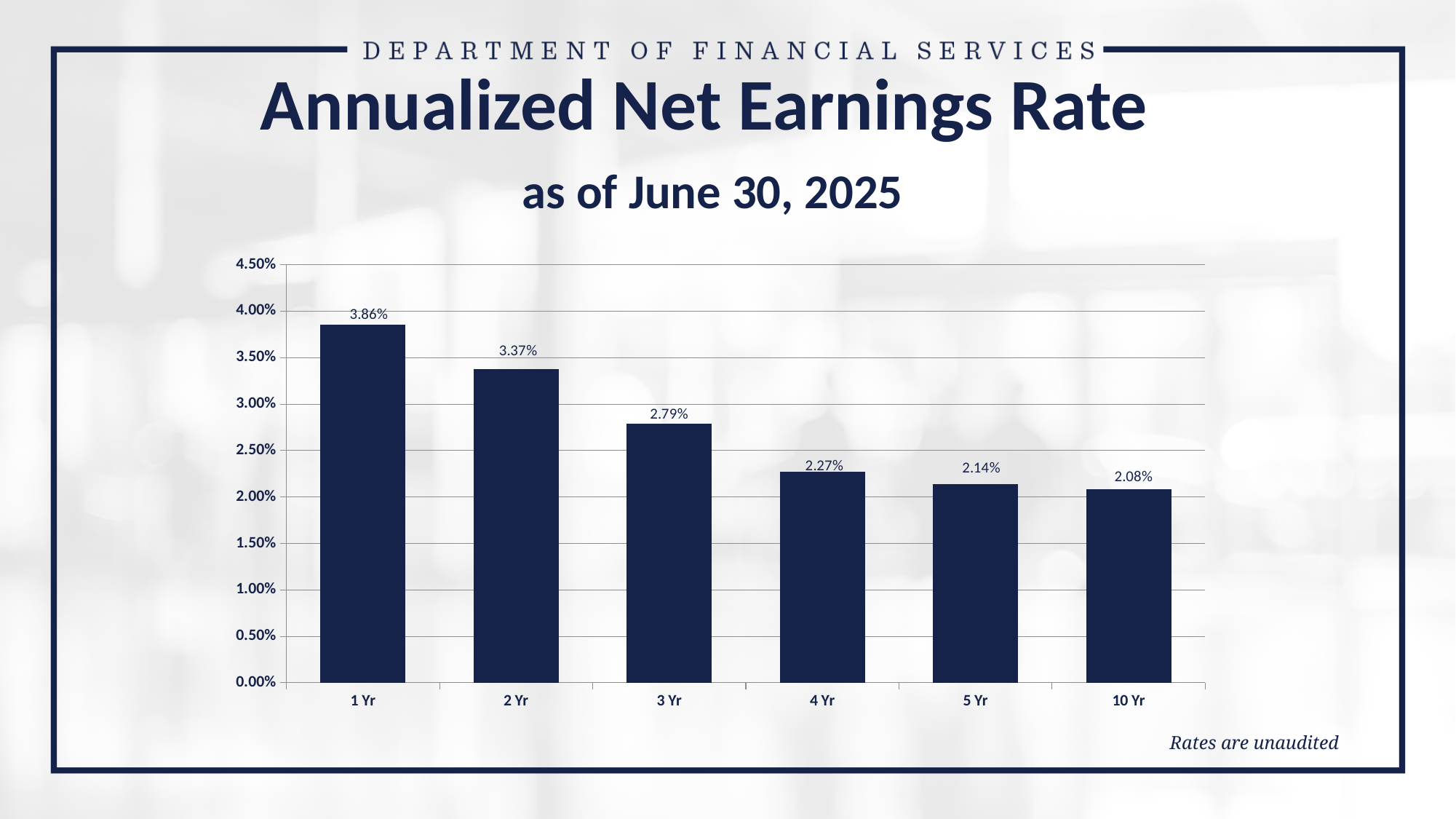
Which period has the lowest annualized net earnings rate? 10 Yr How many periods are shown on the x axis? 6 What is the difference between the 4 Yr and 5 Yr annualized net earnings rates? 0.13% Do the annualized net earnings rates rise or fall from 1 Yr to 10 Yr? Fall What is the annualized net earnings rate for 1 Yr? 3.86% Which period has the highest annualized net earnings rate? 1 Yr Is the value for 5 Yr greater or less than 2.50%? less What kind of chart is shown on the slide? Bar chart What is the annualized net earnings rate for 3 Yr? 2.79% What is the difference between the 1 Yr and 2 Yr annualized net earnings rates? 0.49% Which is larger, the 2 Yr rate or the 3 Yr rate? 2 Yr What is the annualized net earnings rate for 10 Yr? 2.08%